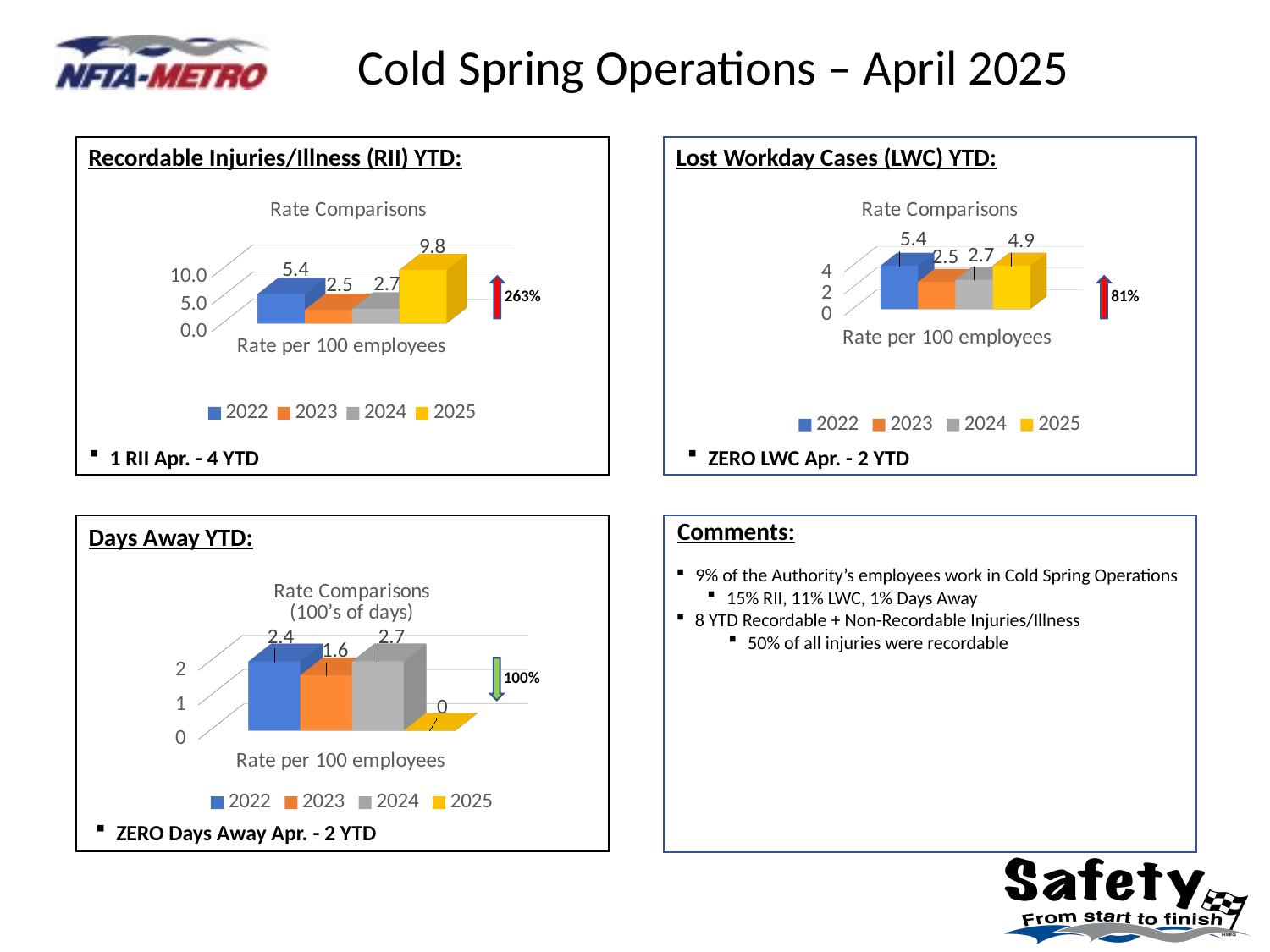
What kind of chart is the Recordable Injuries/Illness (RII) YTD chart? Bar chart What is the title of the chart in the Lost Workday Cases (LWC) YTD box? Rate Comparisons How many series does the legend list in the Days Away YTD chart? 4 In the Days Away YTD chart, which year has the highest rate? 2024 In the Days Away YTD chart, what is the value for 2025? 0 In the Days Away YTD chart, what is the difference between the 2022 and 2023 values? 0.8 In the Recordable Injuries/Illness (RII) YTD chart, what is the difference between the 2025 and 2022 values? 4.4 In the Recordable Injuries/Illness (RII) YTD chart, what is the value for 2025? 9.8 In the Lost Workday Cases (LWC) YTD chart, which year has the lowest rate? 2023 In the Lost Workday Cases (LWC) YTD chart, which is larger, the value for 2022 or the value for 2025? 2022 In the Lost Workday Cases (LWC) YTD chart, what is the value for 2025? 4.9 In the Recordable Injuries/Illness (RII) YTD chart, which year has the highest rate? 2025